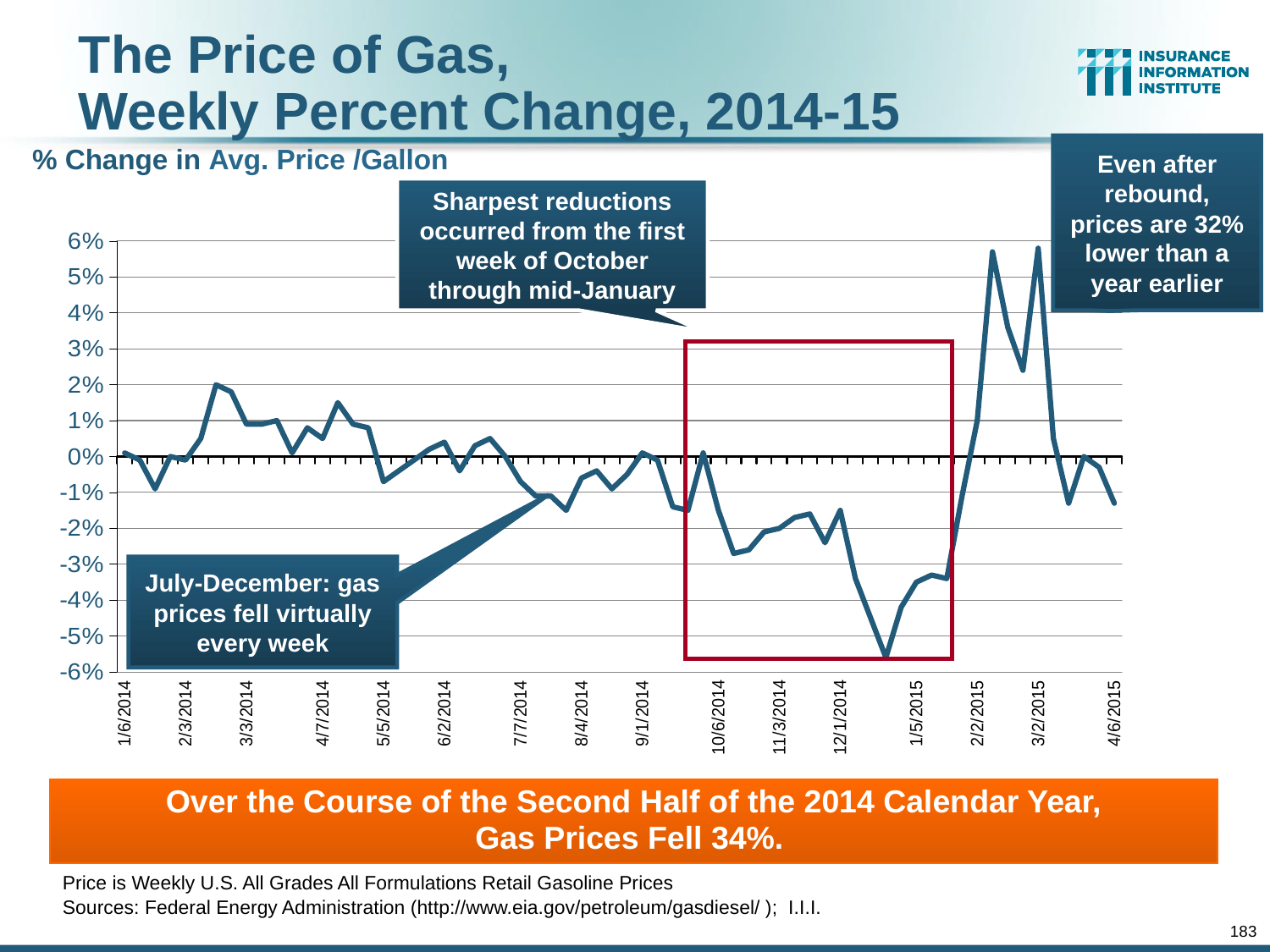
What label is given to the vertical axis of the chart? % Change in Avg. Price /Gallon Is the value at 12/1/2014 greater or less than 0%? less Is the value at 4/6/2015 greater or less than 0%? less What kind of chart is shown on the slide? line chart Is the value at 11/3/2014 greater or less than -1%? less How many date labels are shown on the x axis? 16 What is the highest value shown on the y axis? 6% Do the values rise or fall between 1/5/2015 and 2/2/2015? rise What is the title of the chart on the slide? The Price of Gas, Weekly Percent Change, 2014-15